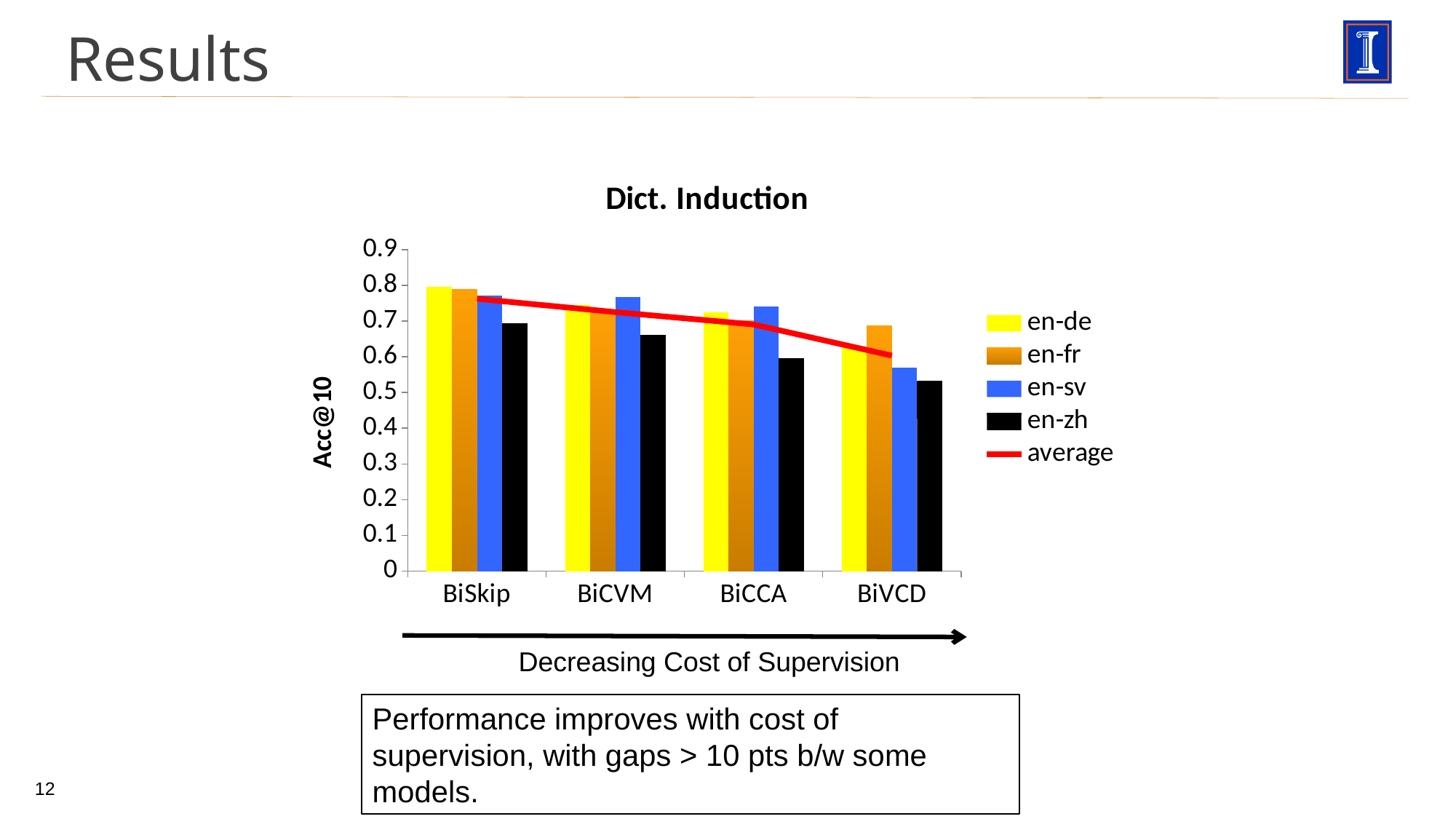
What kind of chart is shown on the slide? combination bar and line chart How many entries does the legend list? 5 Does the average line rise or fall from BiSkip to BiVCD? fall What is the label on the vertical axis of the chart? Acc@10 Is the en-zh value for BiVCD greater or less than 0.6? less For which model is the en-zh value lowest? BiVCD Is the en-fr value for BiVCD greater or less than 0.6? greater How many models (categories) are shown along the x axis? 4 Within the BiVCD group, which is larger: the en-fr value or the en-sv value? en-fr Is the en-de value for BiSkip greater or less than 0.7? greater What is the title of the chart? Dict. Induction